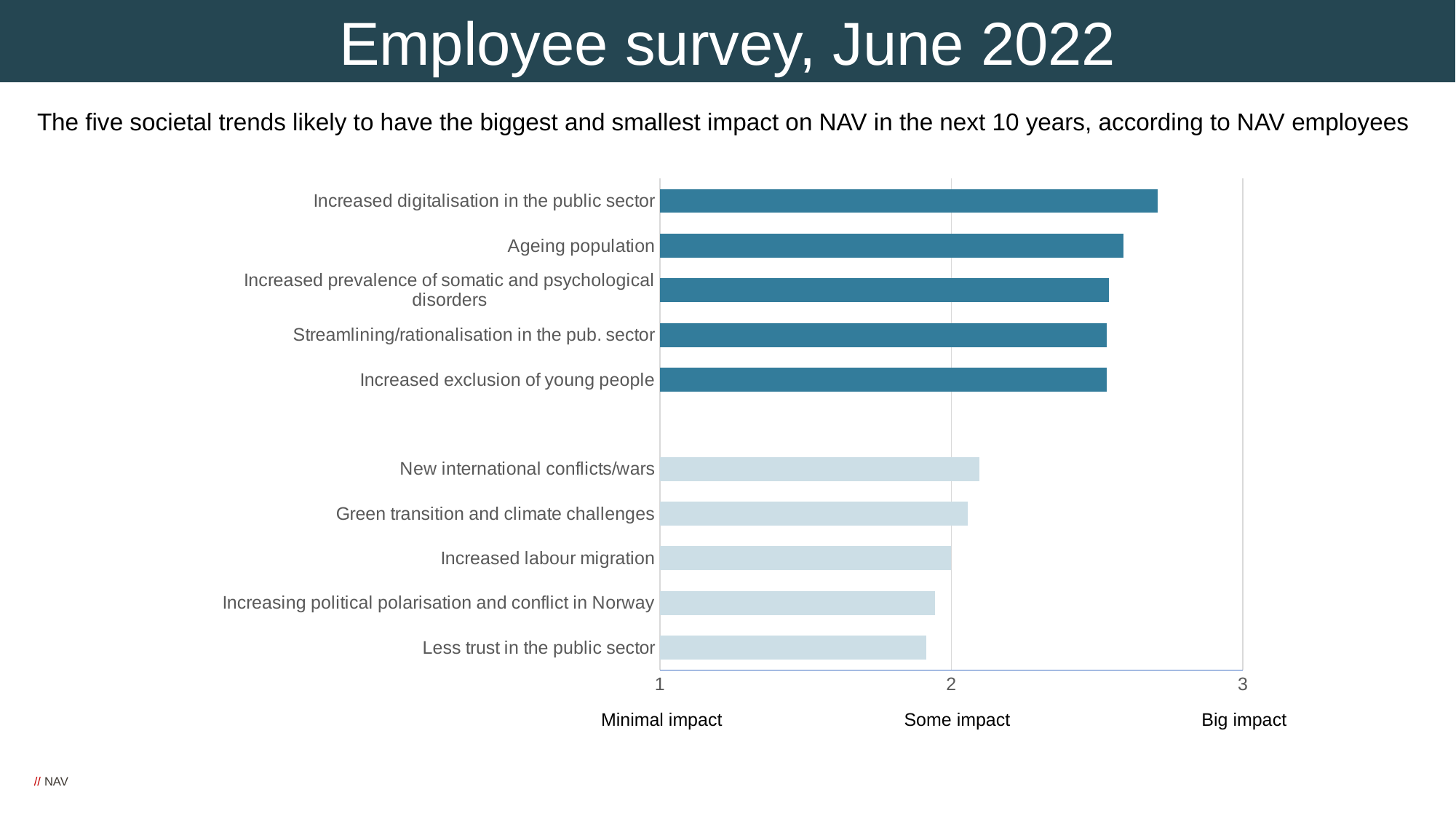
Is the value for Ageing population greater or less than 3? less How many societal trends (categories) are plotted in the chart? 10 What label is shown under the value 3 on the x axis? Big impact Which societal trend has the lowest value in the chart? Less trust in the public sector Which has the larger value: Increased digitalisation in the public sector or Ageing population? Increased digitalisation in the public sector Is the value for Less trust in the public sector greater or less than 2? less Is the value for New international conflicts/wars greater or less than 2? greater Which has the larger value: New international conflicts/wars or Less trust in the public sector? New international conflicts/wars How many bars are drawn in the darker blue colour? 5 Which societal trend has the highest value in the chart? Increased digitalisation in the public sector What kind of chart is shown on the slide? Bar chart